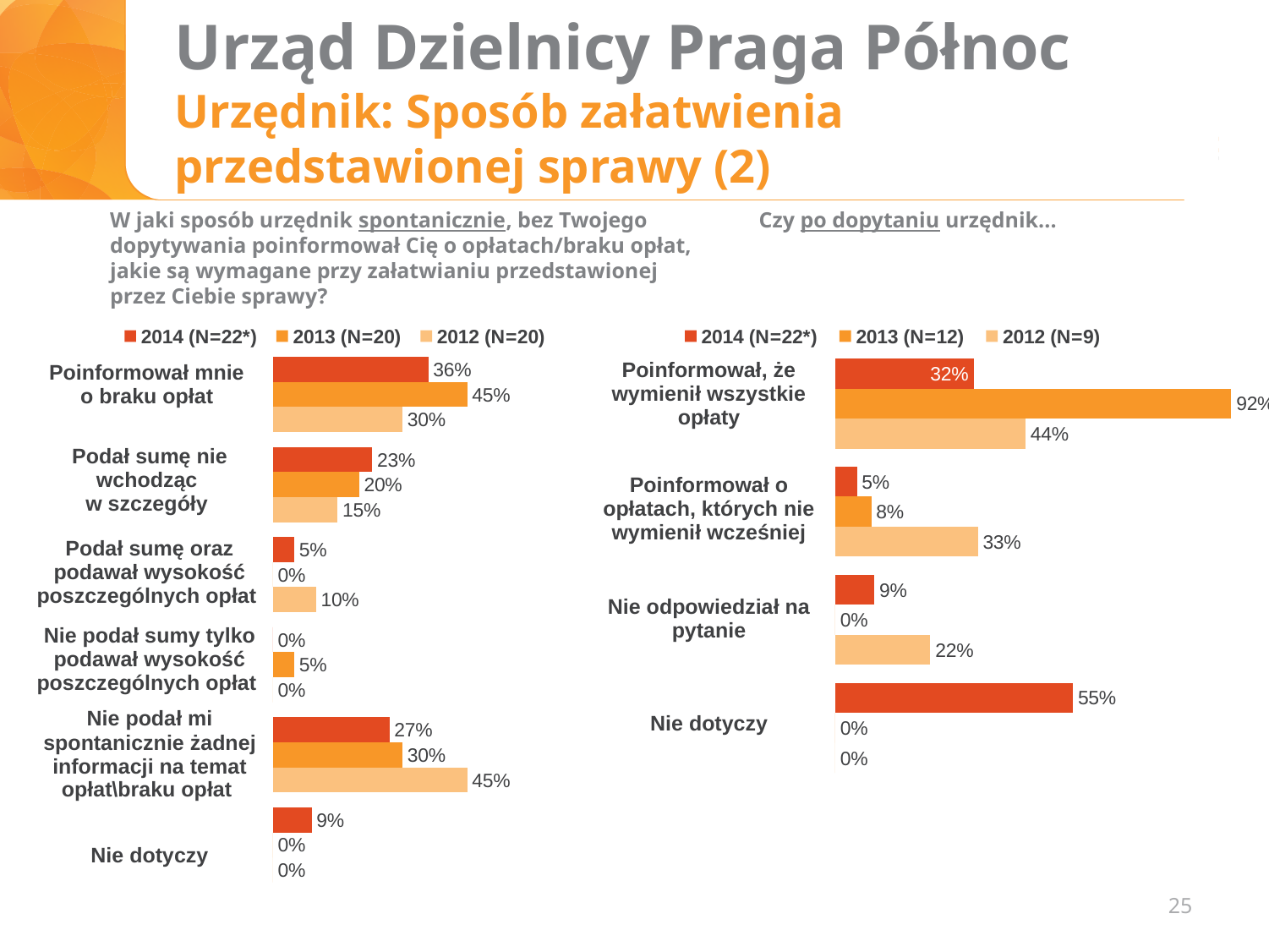
What type of chart is the left chart? Bar chart How many categories does the right chart show? 4 In the right chart ("Czy po dopytaniu urzędnik..."), what is the 2013 (N=12) value for "Poinformował, że wymienił wszystkie opłaty"? 92% In the left chart (spontaneous information about fees), what is the 2013 (N=20) value for "Poinformował mnie o braku opłat"? 45% In the right chart, which category has the highest 2014 (N=22*) value? Nie dotyczy In the right chart, which is larger for "Poinformował o opłatach, których nie wymienił wcześniej": the 2012 (N=9) value or the 2013 (N=12) value? 2012 (N=9) In the right chart, what is the difference between the 2013 (N=12) and 2014 (N=22*) values for "Poinformował, że wymienił wszystkie opłaty"? 60% How many categories does the left chart show? 6 In the left chart, which category has the highest 2014 (N=22*) value? Poinformował mnie o braku opłat In the left chart, what is the difference between the 2014 (N=22*) and 2012 (N=20) values for "Podał sumę nie wchodząc w szczegóły"? 8% In the left chart, what is the 2012 (N=20) value for "Nie podał mi spontanicznie żadnej informacji na temat opłat\braku opłat"? 45% How many series does the legend of the right chart list? 3